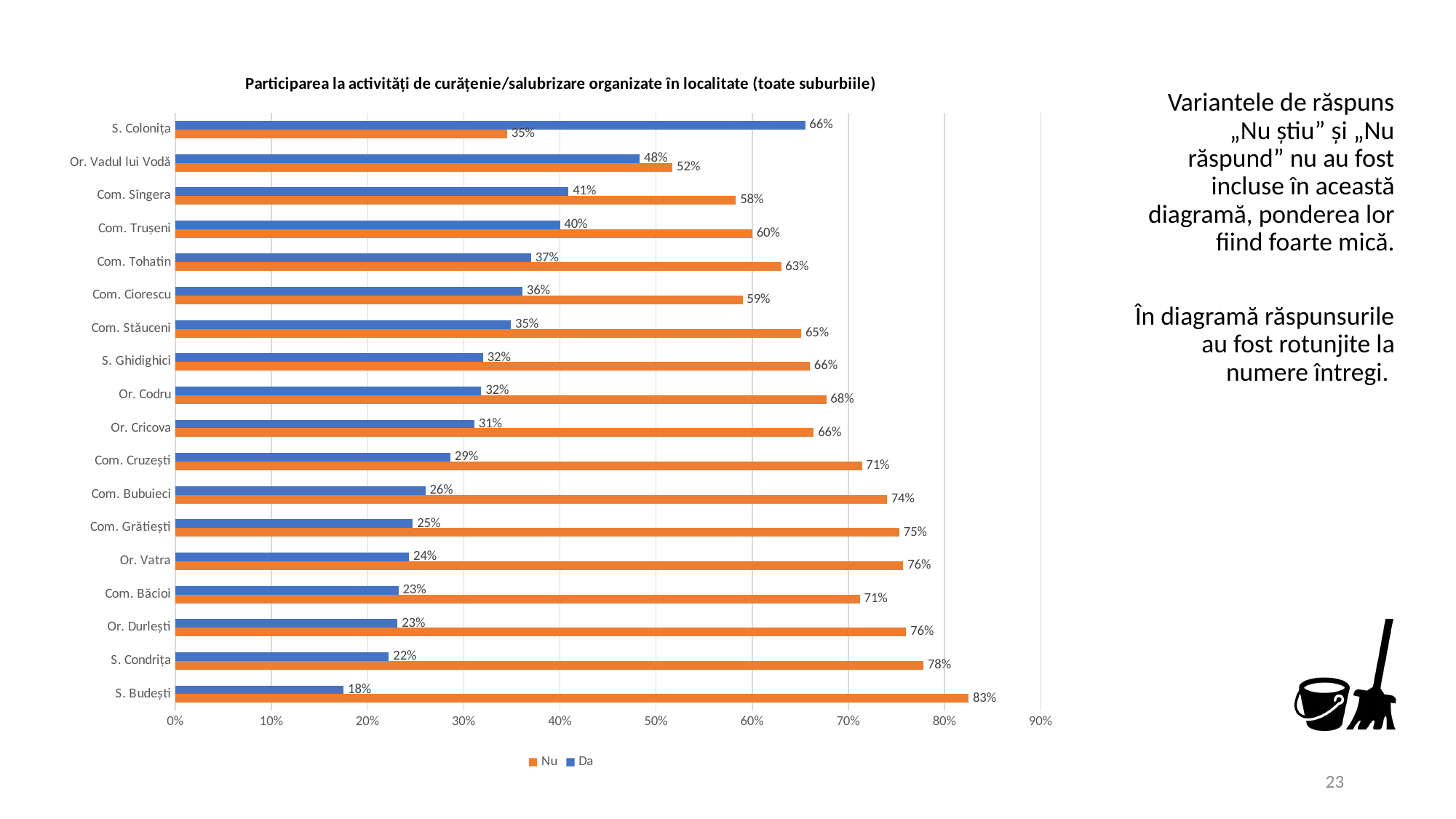
What is the "Da" value for S. Colonița? 66% What is the "Da" value for Or. Vadul lui Vodă? 48% Which locality has the lowest "Nu" value? S. Colonița Which colour represents the "Nu" series? Orange Which is larger for Or. Vadul lui Vodă, the "Nu" value or the "Da" value? Nu How many series does the legend list? 2 What kind of chart is shown on the slide? Bar chart Which locality has the lowest "Da" value? S. Budești Which locality has the highest "Nu" value? S. Budești How many localities are shown on the chart? 18 What is the difference between the "Nu" and "Da" values for Com. Trușeni? 20% What is the "Nu" value for Com. Tohatin? 63%